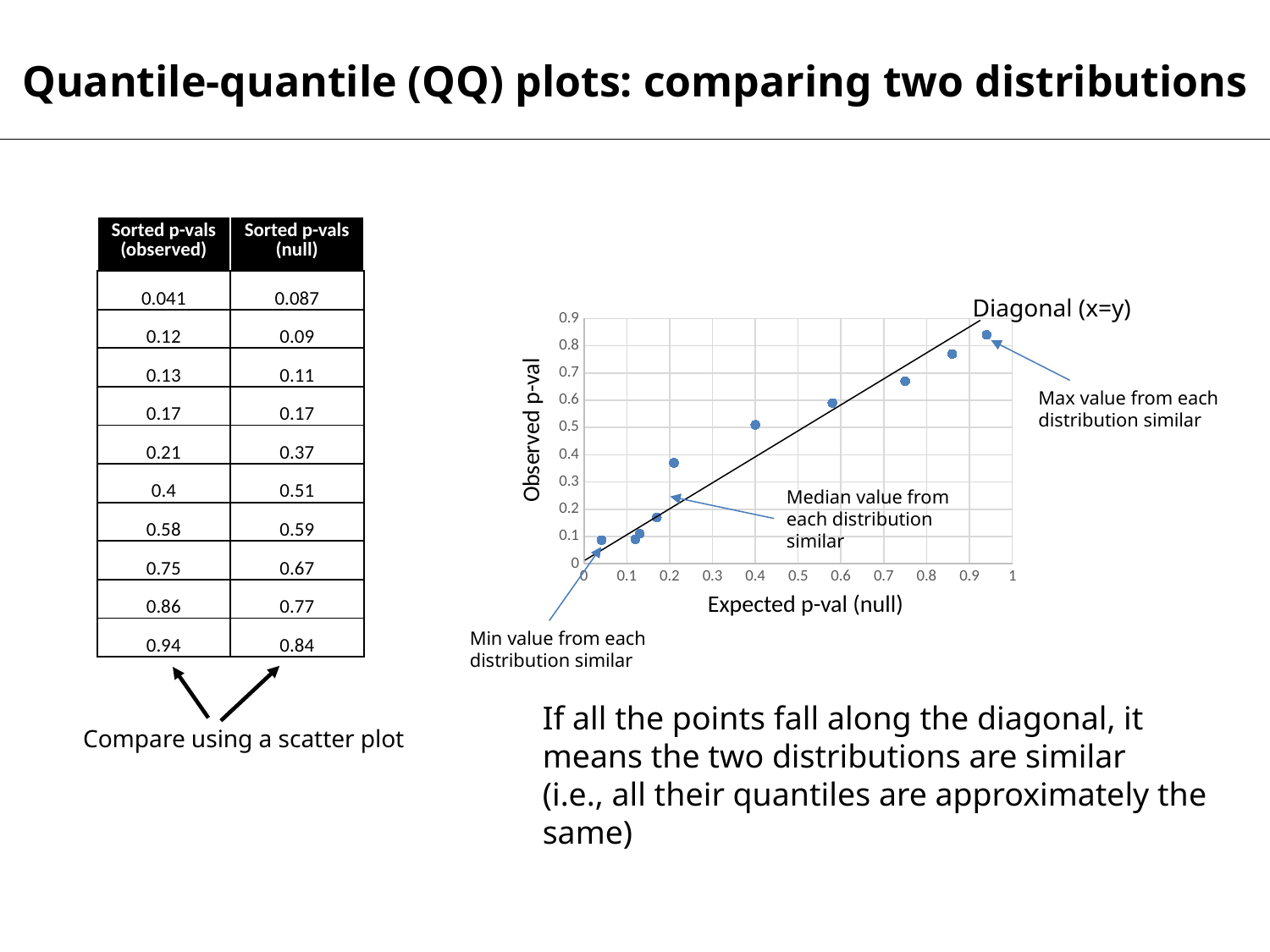
According to the table of sorted p-values, what is the smallest observed p-value plotted? 0.041 According to the table of sorted p-values, what is the largest observed p-value plotted? 0.94 Is the observed p-value of the point with the largest expected p-value greater or less than 0.9? less What is the label of the y axis of the scatter plot? Observed p-val Do the observed p-values rise or fall as the expected p-value increases along the x axis? rise What is the label of the x axis of the scatter plot? Expected p-val (null) What is the difference between the largest observed p-value (0.94) and the largest null p-value (0.84) in the table? 0.1 How many data points are plotted in the scatter plot? 10 What kind of chart is shown on the slide? scatter plot